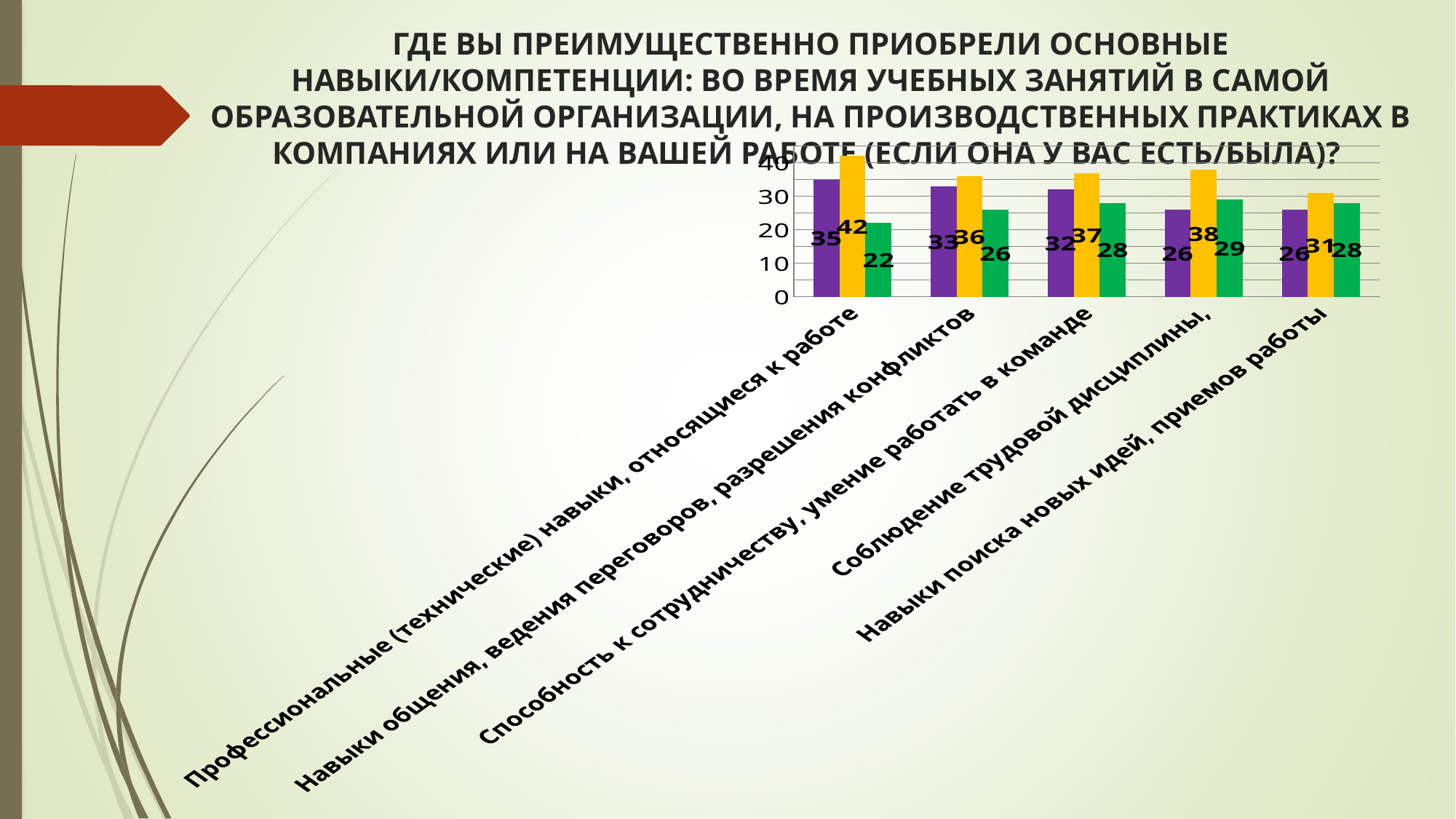
Which category has the lowest green bar? Профессиональные (технические) навыки, относящиеся к работе Is the value of the purple bar for 'Соблюдение трудовой дисциплины' greater or less than 30? less Which category has the highest yellow bar? Профессиональные (технические) навыки, относящиеся к работе For 'Способность к сотрудничеству, умение работать в команде', which is larger: the purple bar or the yellow bar? the yellow bar What type of chart is shown on the slide? bar chart What is the value of the purple bar for 'Профессиональные (технические) навыки, относящиеся к работе'? 35 What is the difference between the yellow and green bars for 'Профессиональные (технические) навыки, относящиеся к работе'? 20 What is the value of the yellow bar for 'Профессиональные (технические) навыки, относящиеся к работе'? 42 What is the value of the green bar for 'Навыки общения, ведения переговоров, разрешения конфликтов'? 26 What is the value of the green bar for 'Навыки поиска новых идей, приемов работы'? 28 How many categories are shown on the x axis of the chart? 5 What is the value of the yellow bar for 'Соблюдение трудовой дисциплины'? 38